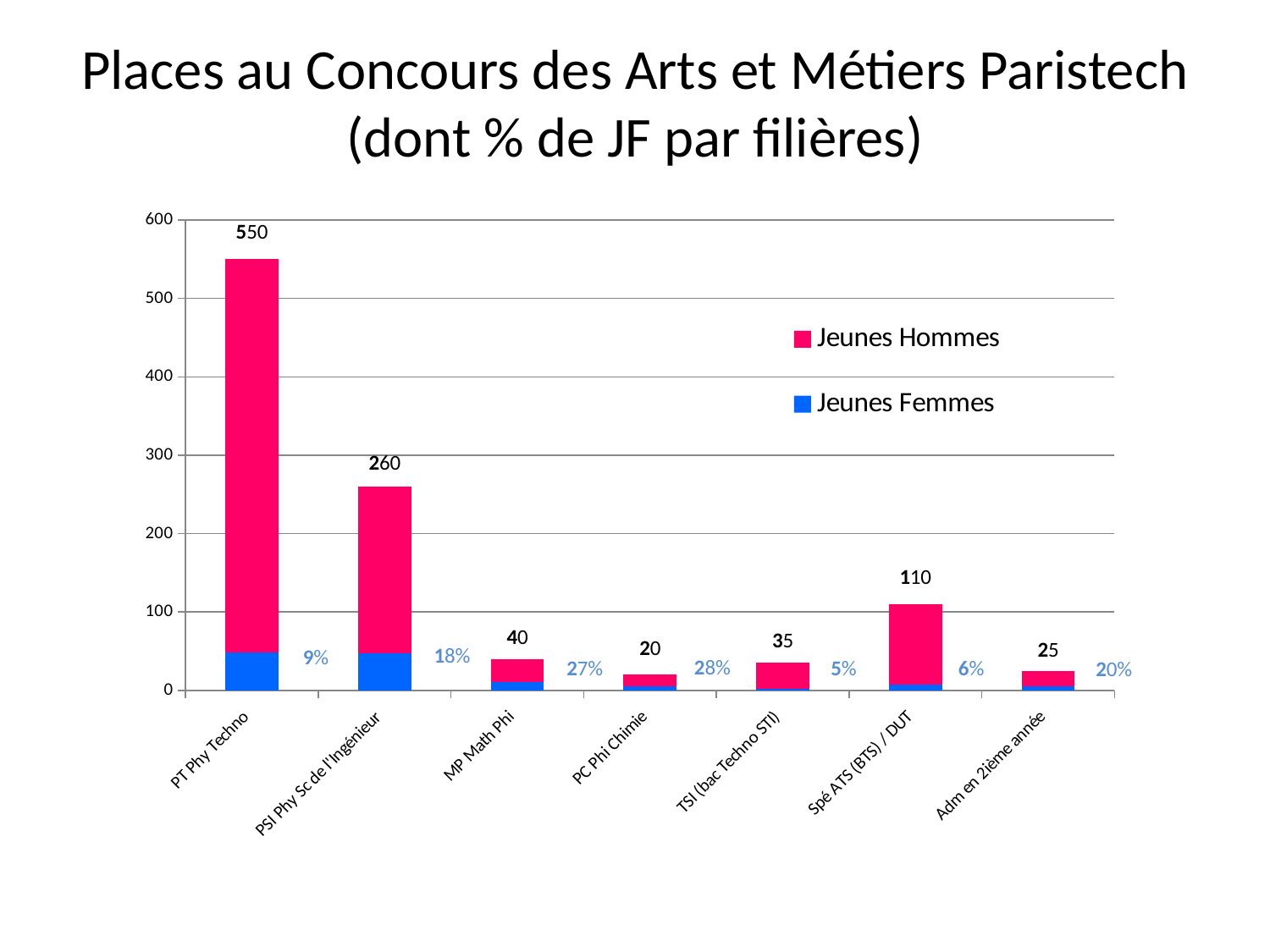
What is the total number of places shown for PT Phy Techno? 550 What is the total number of places shown for Spé ATS (BTS) / DUT? 110 What percentage of JF is shown next to the PC Phi Chimie bar? 28% Which has more total places, MP Math Phi or TSI (bac Techno STI)? MP Math Phi Is the total for PSI Phy Sc de l'Ingénieur greater or less than 300? less What kind of chart is shown on the slide? Stacked bar chart Which filière has the highest total number of places? PT Phy Techno Which filière has the lowest total number of places? PC Phi Chimie How many filières (categories) are shown on the x axis? 7 What is the difference in total places between PT Phy Techno and PSI Phy Sc de l'Ingénieur? 290 How many series does the legend list? 2 What percentage of JF is shown next to the TSI (bac Techno STI) bar? 5%